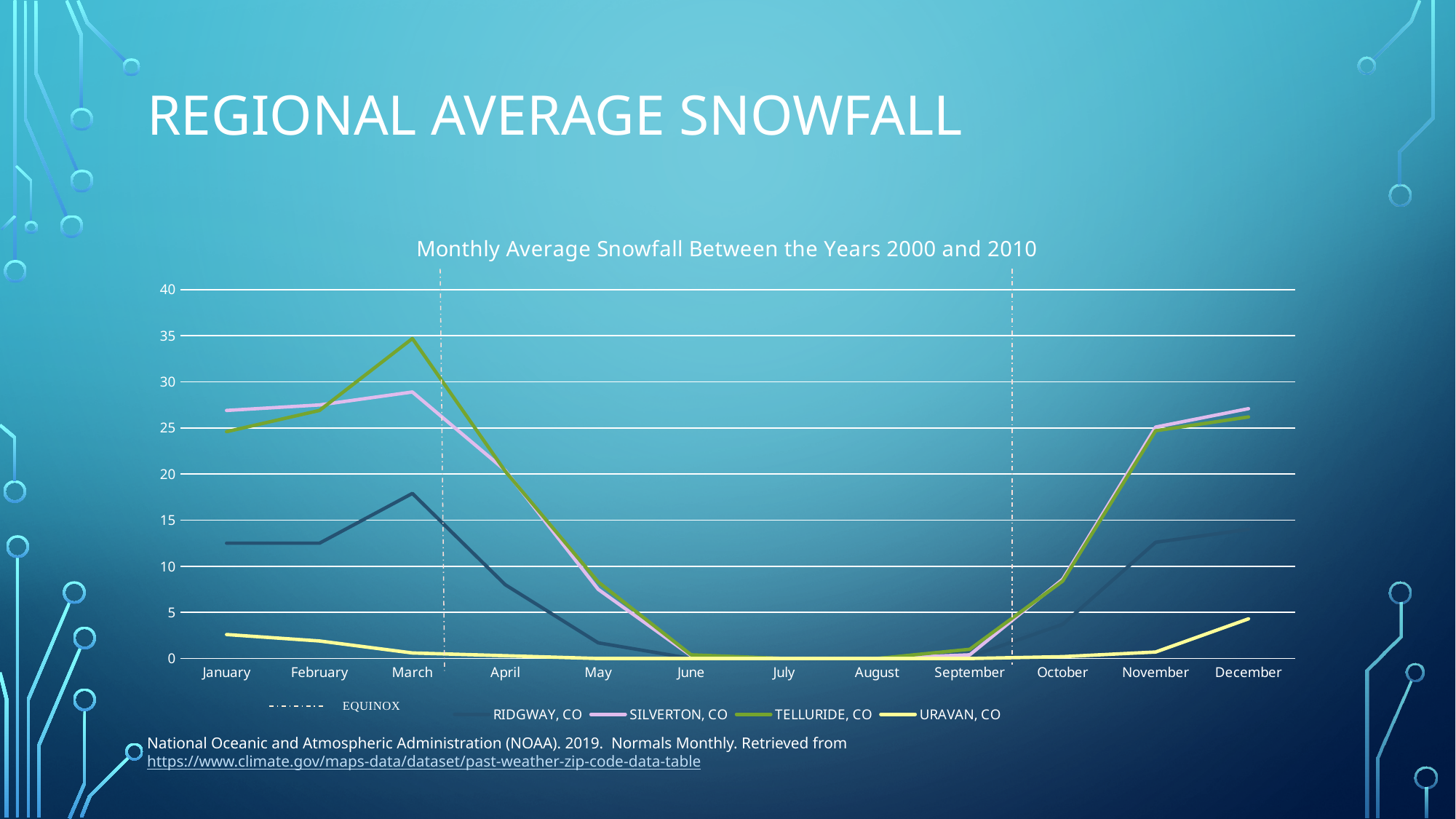
What is the title of the chart? Monthly Average Snowfall Between the Years 2000 and 2010 Which location has the lowest snowfall values across the year? Uravan, CO Which is larger in January, the value for Silverton, CO or the value for Telluride, CO? Silverton, CO Does the Telluride, CO line rise or fall from March to June? Fall How many Colorado locations does the chart legend list as data series? 4 Is the value for Telluride, CO in March greater or less than 30? greater What kind of chart is shown on the slide? Line chart Is the value for Silverton, CO in June greater or less than 5? less In which month does the Telluride, CO line reach its highest value? March How many months are shown along the x axis of the chart? 12 Is the value for Ridgway, CO in March greater or less than 15? greater Which location has the highest snowfall value in March? Telluride, CO